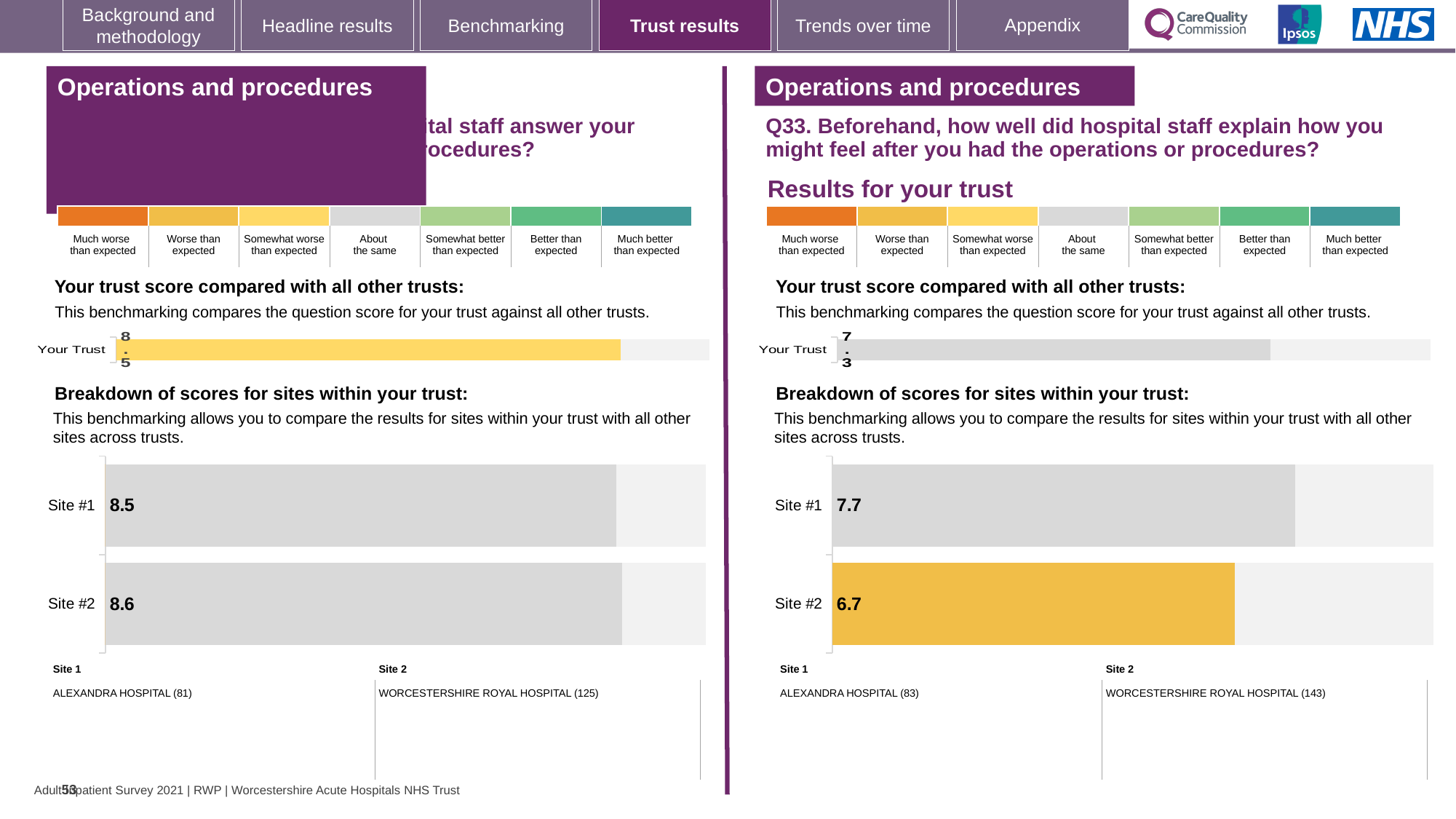
On the left-hand 'Breakdown of scores for sites within your trust' chart, what is the score for Site #1? 8.5 What type of chart is used for the site breakdown on the right-hand Q33 section? Bar chart On the right-hand Q33 site breakdown chart, what colour is the bar for Site #2? Yellow On the left-hand 'Breakdown of scores for sites within your trust' chart, what is the score for Site #2? 8.6 On the right-hand Q33 'Breakdown of scores for sites within your trust' chart, what is the score for Site #1? 7.7 On the left-hand site breakdown chart, which site has the lower score? Site #1 On the right-hand Q33 site breakdown chart, what is the difference between the Site #1 and Site #2 scores? 1.0 On the right-hand Q33 'Breakdown of scores for sites within your trust' chart, what is the score for Site #2? 6.7 How many sites are shown on the right-hand Q33 site breakdown chart? 2 On the right-hand Q33 'Your trust score compared with all other trusts' chart, what is the score shown for Your Trust? 7.3 On the right-hand Q33 site breakdown chart, which site has the higher score? Site #1 On the left-hand 'Your trust score compared with all other trusts' chart, what is the score shown for Your Trust? 8.5